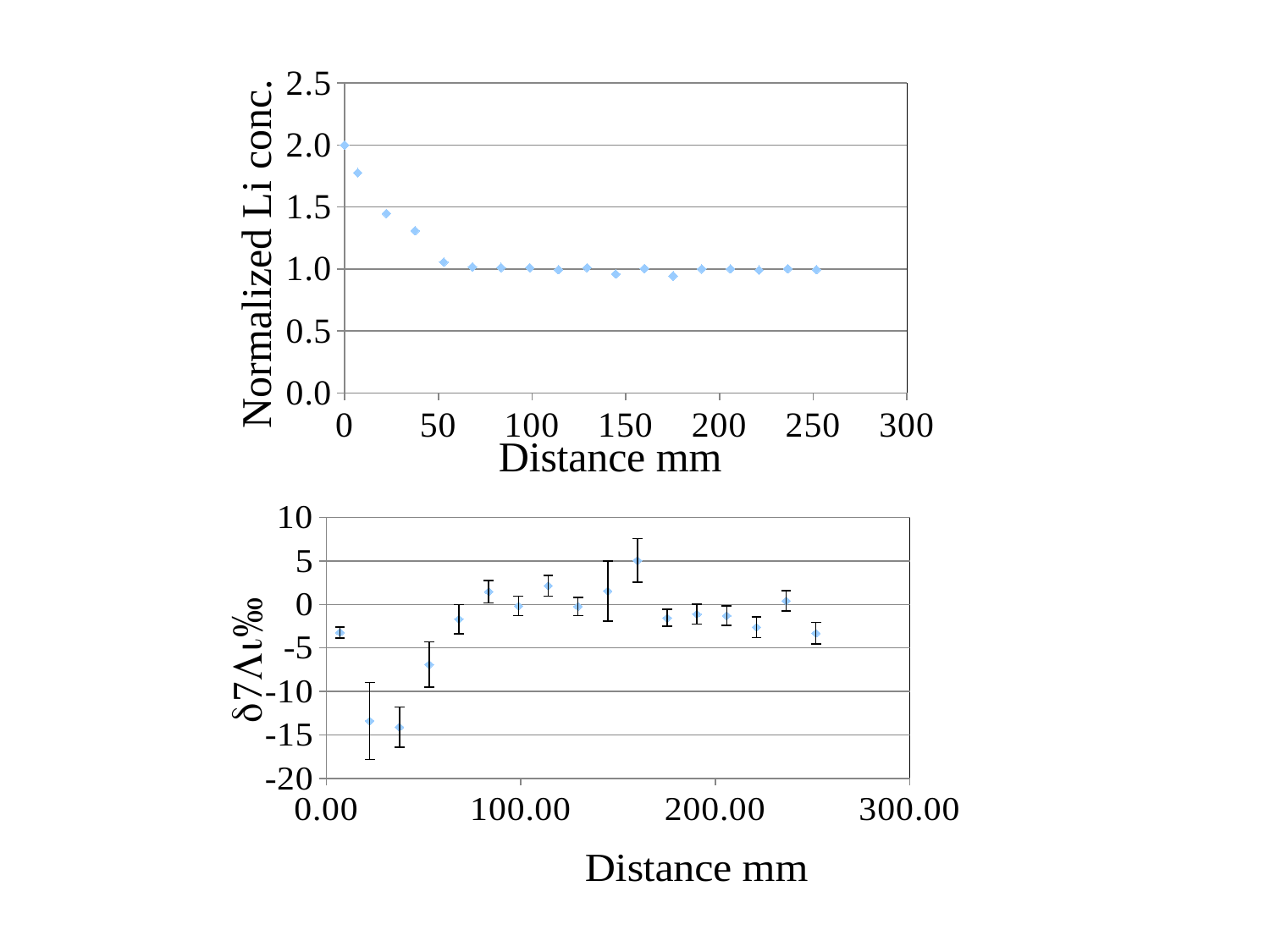
In the bottom chart, is the δ7Li‰ value at about 160 mm greater or less than 0? greater In the top chart, at which distance is the Normalized Li conc. highest? 0 mm What is the y-axis label of the top chart? Normalized Li conc. In the top chart, is the Normalized Li conc. at distance 0 mm greater or less than 1.5? greater What kind of chart is the bottom chart (δ7Li‰ vs Distance mm)? scatter chart with error bars In the bottom chart, do the δ7Li‰ values rise or fall as distance increases from about 40 mm to about 80 mm? rise In the top chart, is the Normalized Li conc. at about 250 mm greater or less than 1.5? less What kind of chart is the top chart (Normalized Li conc. vs Distance mm)? scatter chart What is the x-axis label of the top chart? Distance mm In the top chart, do the Normalized Li conc. values rise or fall as distance increases from 0 to 50 mm? fall In the bottom chart, which is larger: the δ7Li‰ value at about 160 mm or at about 250 mm? about 160 mm